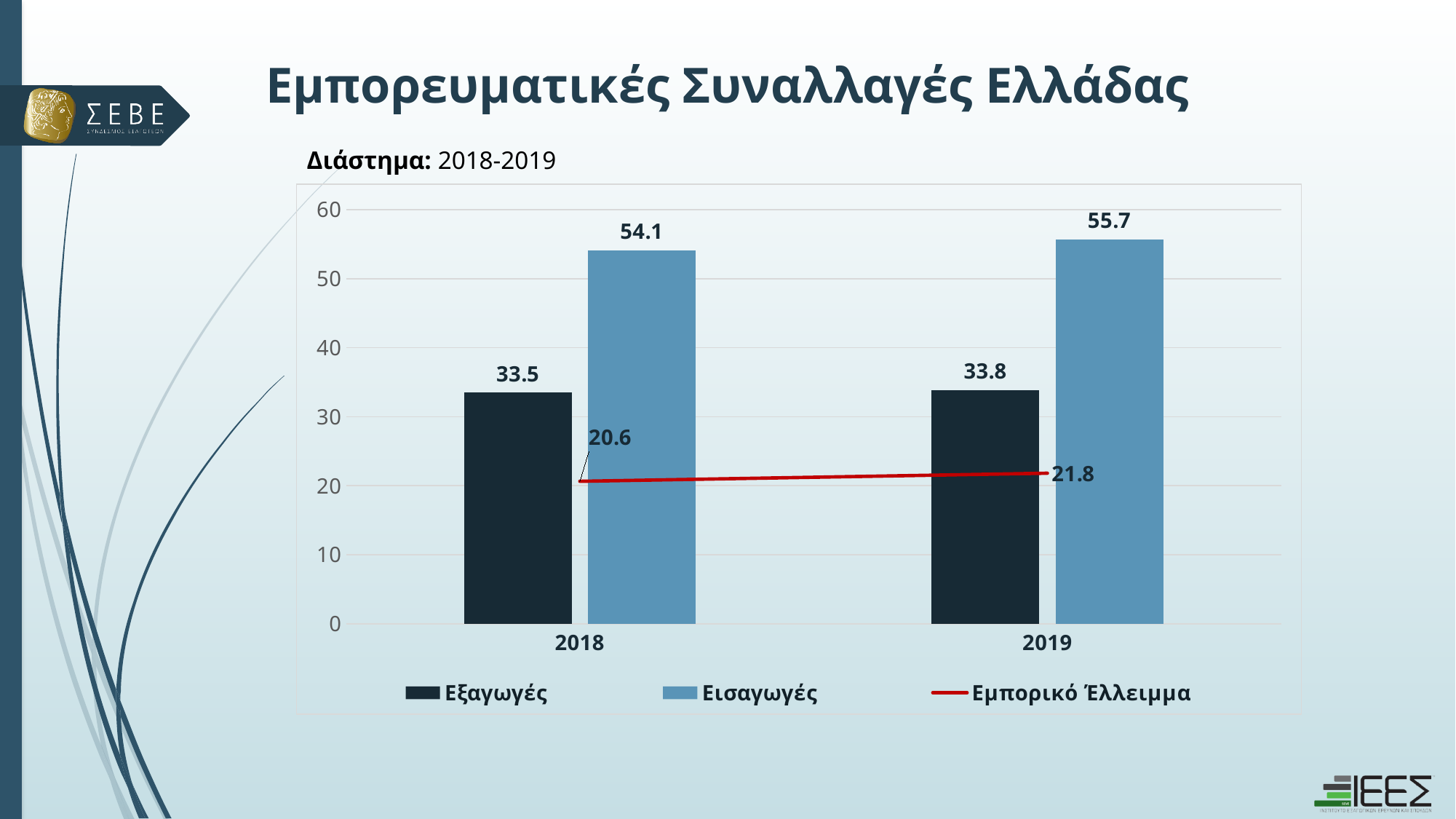
What is the value of Εισαγωγές (imports) in 2019? 55.7 How many years are shown on the x axis? 2 Is the value for Εξαγωγές in 2018 larger or smaller than the value for Εισαγωγές in 2018? smaller Does the Εμπορικό Έλλειμμα line rise or fall from 2018 to 2019? rise By how much did Εισαγωγές (imports) increase from 2018 to 2019? 1.6 What is the value of Εμπορικό Έλλειμμα (trade deficit) in 2018? 20.6 What is the value of Εμπορικό Έλλειμμα (trade deficit) in 2019? 21.8 How many series does the legend list? 3 What colour are the Εισαγωγές bars? light blue What is the difference between Εισαγωγές and Εξαγωγές in 2019? 21.9 Which year has the higher value for Εισαγωγές (imports)? 2019 What is the value of Εξαγωγές (exports) in 2018? 33.5